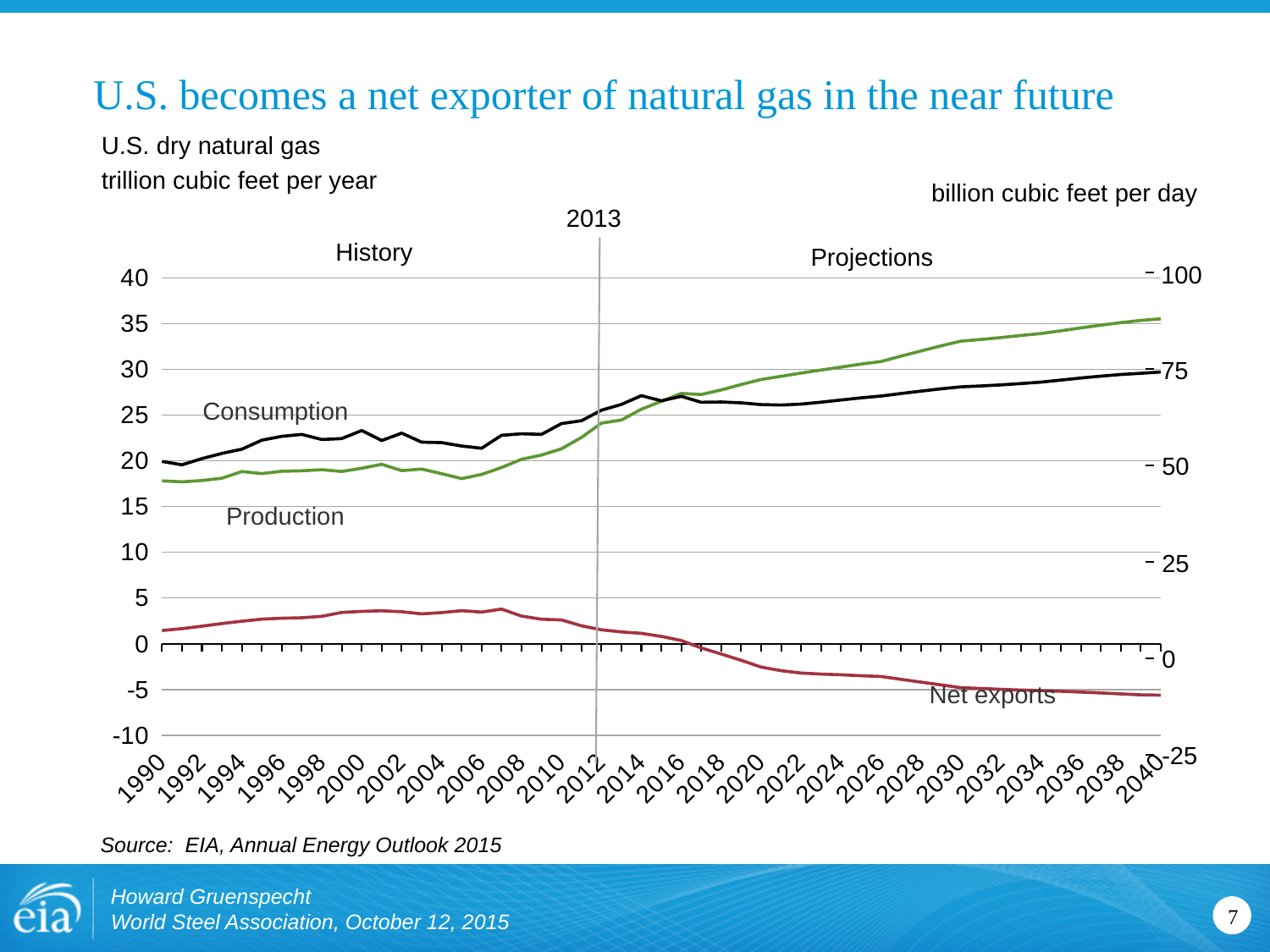
What kind of chart is shown on the slide? line chart Is the value for Production in 2040 greater or less than 30 trillion cubic feet per year? greater Is the value for Production in 1990 greater or less than 20 trillion cubic feet per year? less How many data series are plotted on the chart? 3 Is the value for Net exports in 2000 greater or less than 0? greater Which series is higher in 1990, Consumption or Production? Consumption Does the Net exports line rise or fall between 2008 and 2040? fall Does the Production line rise or fall between 2013 and 2040? rise What year does the vertical line separating History from Projections mark? 2013 Which series is higher in 2040, Production or Consumption? Production